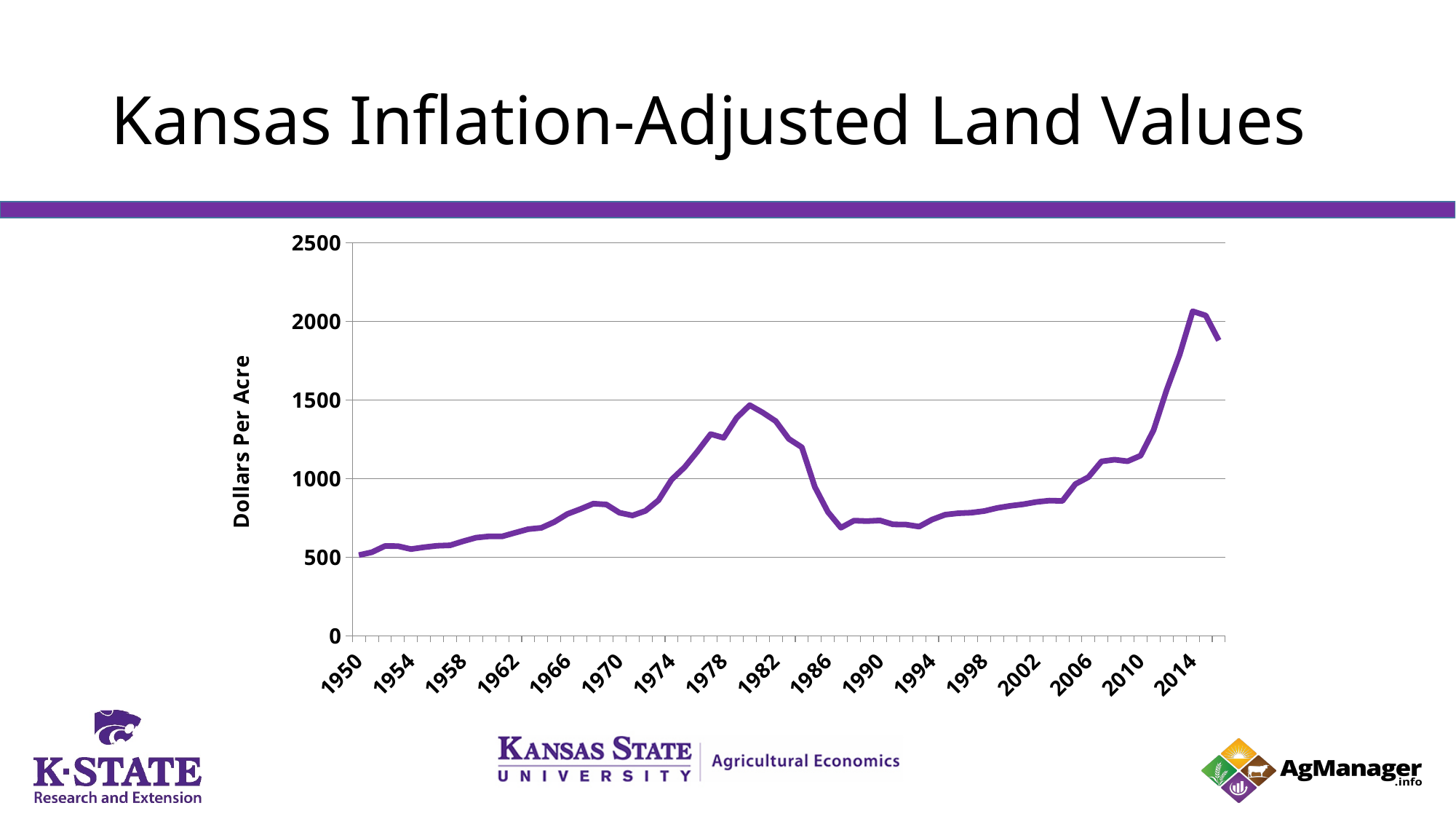
What is the title of the chart on the slide? Kansas Inflation-Adjusted Land Values Do the values rise or fall between 1982 and 1990? fall Do the values rise or fall between 2006 and 2014? rise Is the highest value on the line greater or less than 2000? greater How many year labels are shown along the x axis? 17 Is the value for 1990 greater or less than 1000? less How many lines (series) are plotted on the chart? 1 Is the value for 1982 greater or less than 1000? greater What is the label on the vertical axis of the chart? Dollars Per Acre What kind of chart is shown on the slide? line chart